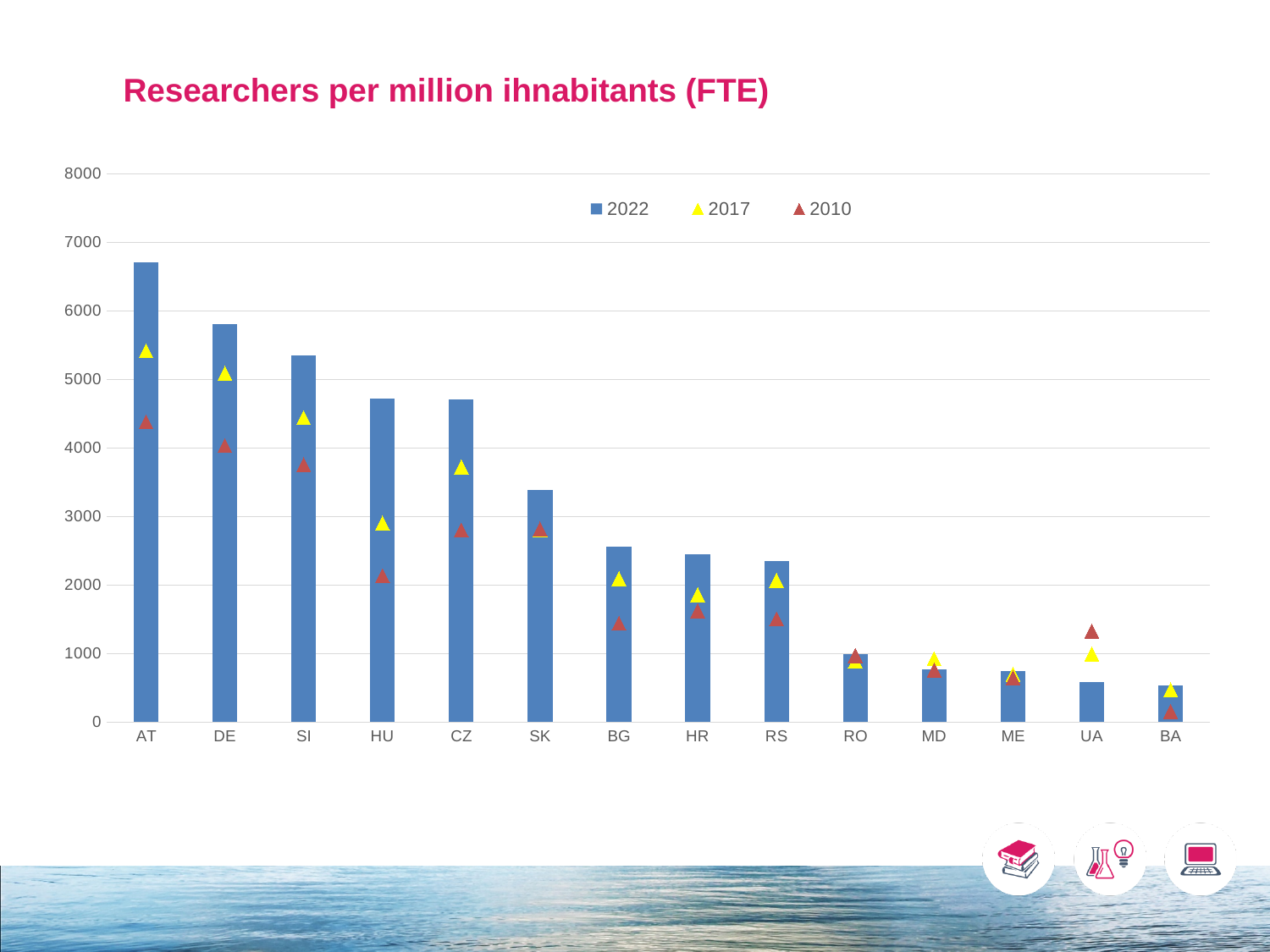
How many countries are shown on the x axis? 14 Do the 2022 bars generally rise or fall from left to right along the x axis? fall How many series does the legend list? 3 Which country has the highest 2022 value? AT For UA, which is larger, the 2010 value or the 2022 value? 2010 Which country has the lowest 2010 value? BA What is the title of the chart? Researchers per million ihnabitants (FTE) Is the 2022 value for MD greater or less than 1000? less Is the 2022 value for AT greater or less than 6000? greater Which is larger, the 2022 value for DE or the 2022 value for SI? DE Is the 2022 value for SK greater or less than 3000? greater